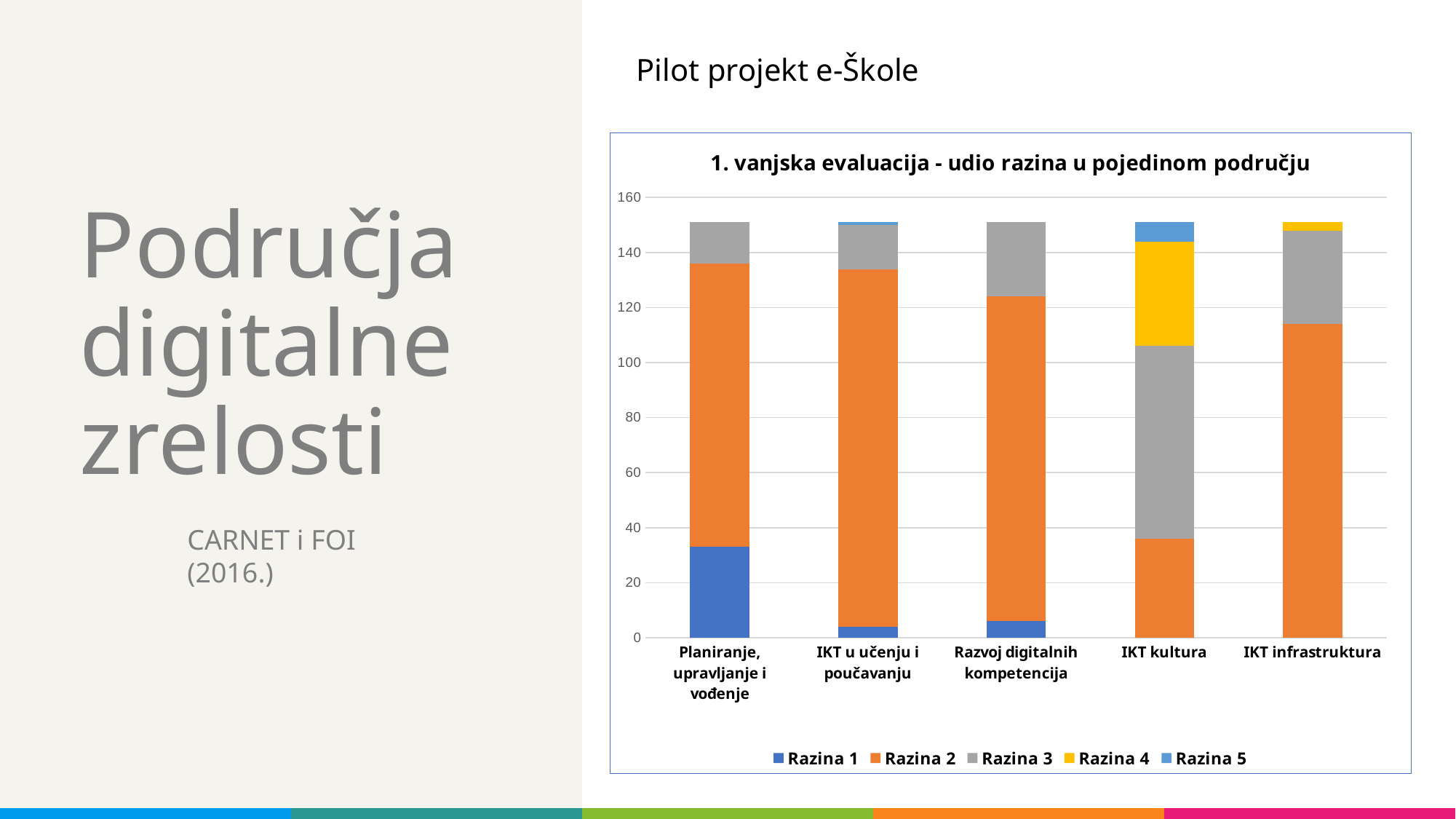
What is the title of the chart? 1. vanjska evaluacija - udio razina u pojedinom području What kind of chart is shown on the slide? stacked bar chart Which category has the smallest Razina 2 segment? IKT kultura Which category has the largest Razina 3 segment? IKT kultura Which category has the largest Razina 1 segment? Planiranje, upravljanje i vođenje How many series does the chart legend list? 5 Which is larger: the Razina 1 segment for Planiranje, upravljanje i vođenje or the Razina 1 segment for IKT u učenju i poučavanju? Planiranje, upravljanje i vođenje Is the Razina 2 value for IKT kultura greater or less than 60? less Which category has the largest Razina 4 segment? IKT kultura How many categories (areas) are shown on the x axis of the chart? 5 Is the Razina 1 value for Planiranje, upravljanje i vođenje greater or less than 20? greater Which series is shown in yellow in the chart? Razina 4